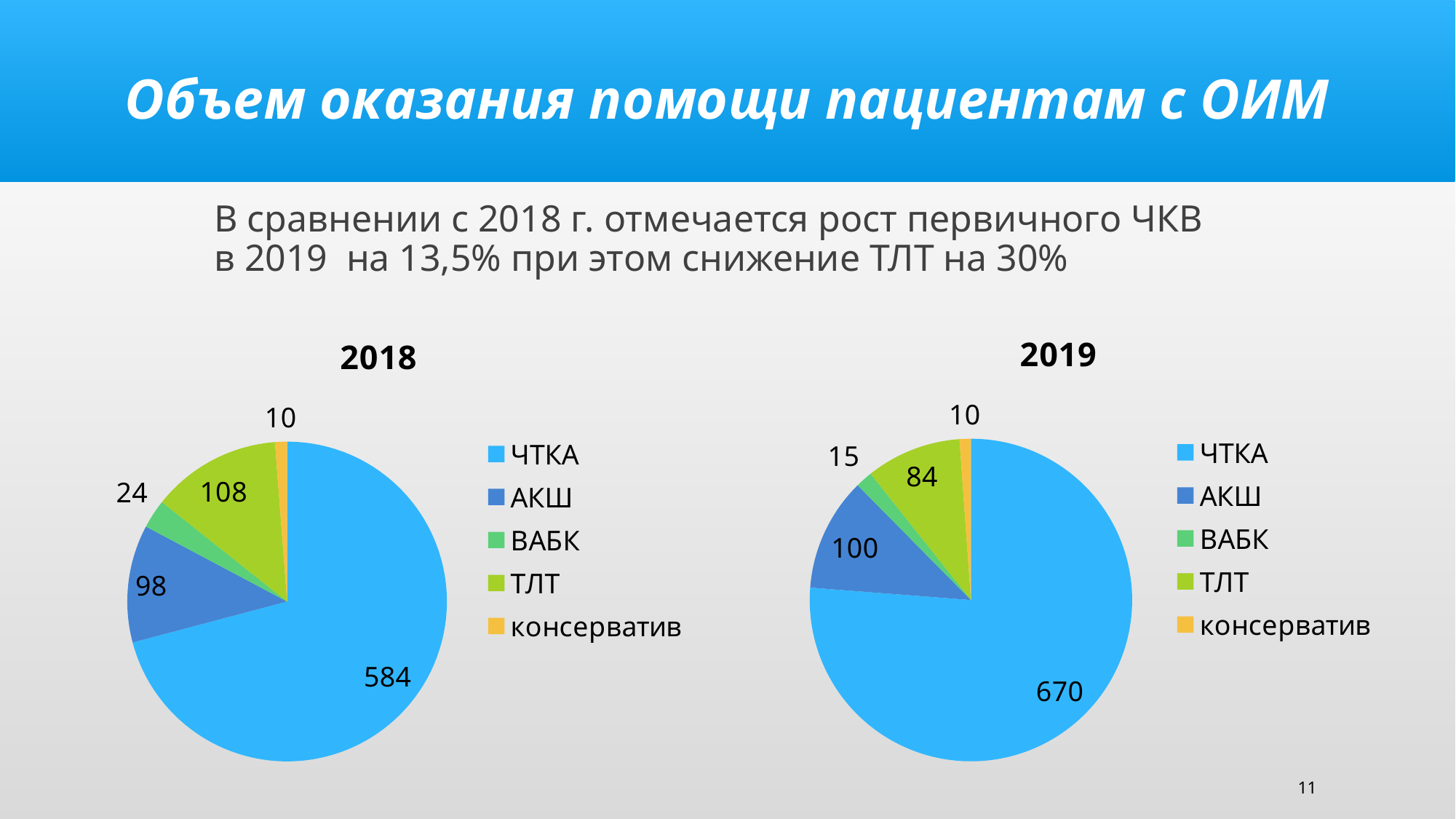
How many categories does the 2018 pie chart show? 5 In the 2018 pie chart, which category has the largest slice? ЧТКА In the 2018 pie chart, what is the value for ЧТКА? 584 In the 2019 pie chart, which is larger: АКШ or ТЛТ? АКШ Which is larger: the ТЛТ value in the 2018 chart or the ТЛТ value in the 2019 chart? 2018 What type of chart is used for the 2019 data? Pie chart In the 2019 chart legend, which category is shown in orange? консерватив In the 2019 pie chart, what is the value for ВАБК? 15 In the 2019 pie chart, which category has the smallest slice? консерватив What is the difference between the ЧТКА value in the 2019 chart and the ЧТКА value in the 2018 chart? 86 In the 2018 pie chart, what is the difference between the ТЛТ value and the АКШ value? 10 In the 2019 pie chart, what is the value for ТЛТ? 84